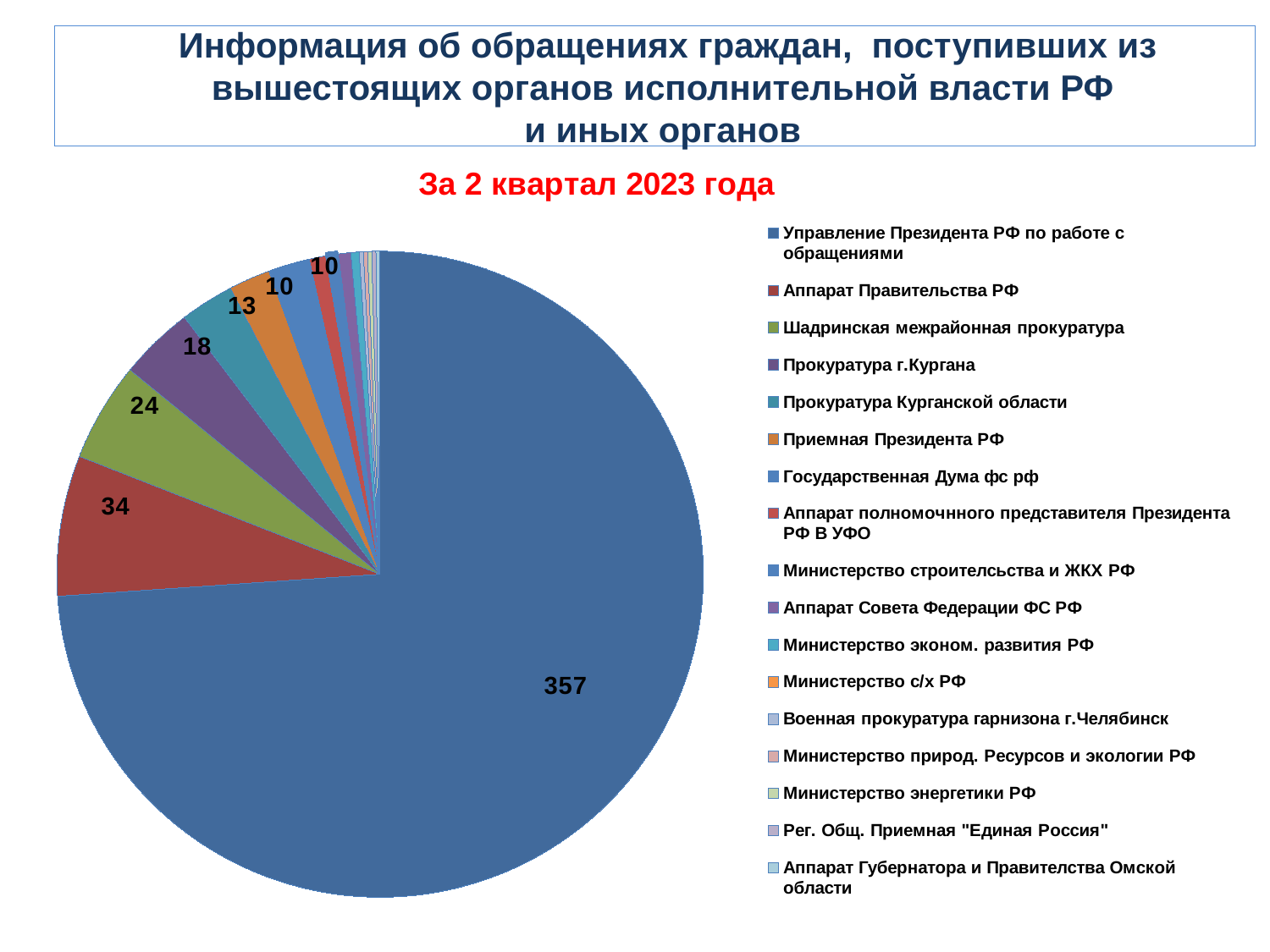
What value is shown for Прокуратура г.Кургана? 18 Which category has the largest slice of the pie? Управление Президента РФ по работе с обращениями Which is larger, the value for Аппарат Правительства РФ or the value for Прокуратура Курганской области? Аппарат Правительства РФ How many categories does the legend list? 17 What is the difference between the values for Управление Президента РФ по работе с обращениями and Аппарат Правительства РФ? 323 What period does the red subtitle above the chart refer to? За 2 квартал 2023 года What value is shown for Шадринская межрайонная прокуратура? 24 What kind of chart is shown on the slide? Pie chart What value is shown for Аппарат Правительства РФ? 34 What value is shown for Прокуратура Курганской области? 13 What is the difference between the values for Шадринская межрайонная прокуратура and Прокуратура г.Кургана? 6 What value is shown for Управление Президента РФ по работе с обращениями? 357